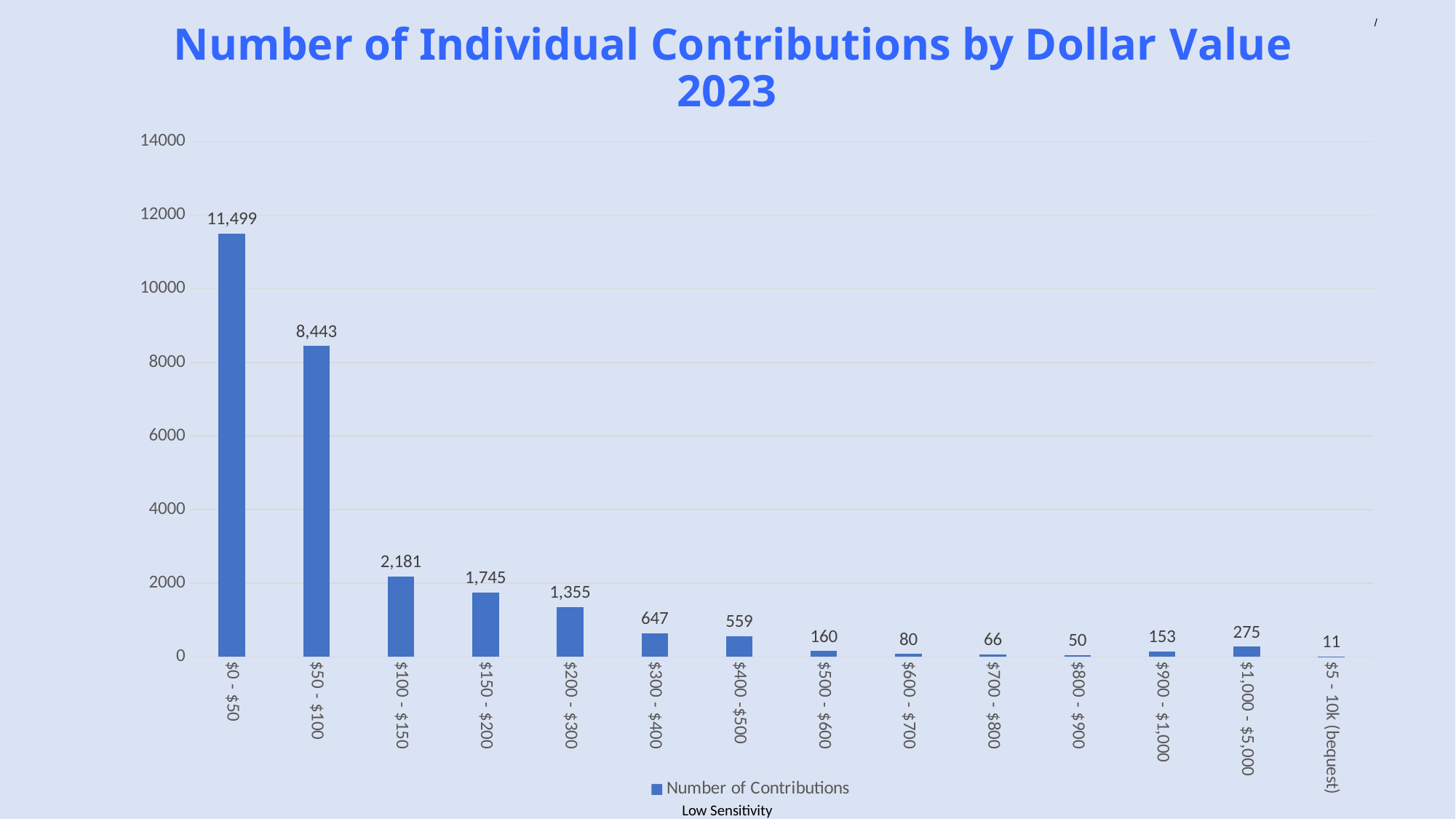
Which category has the highest number of contributions? $0 - $50 What is the number of contributions for the $1,000 - $5,000 category? 275 What is the number of contributions for the $0 - $50 category? 11,499 What is the number of contributions for the $300 - $400 category? 647 Which has more contributions, $900 - $1,000 or $500 - $600? $500 - $600 Is the value for $200 - $300 greater or less than 2000? less What kind of chart is shown on the slide? Bar chart What is the difference between the number of contributions for $100 - $150 and $150 - $200? 436 What is the difference between the number of contributions for $0 - $50 and $50 - $100? 3,056 How many dollar-value categories are shown on the x axis? 14 Which category has the lowest number of contributions? $5 - 10k (bequest) How many series does the legend list? 1